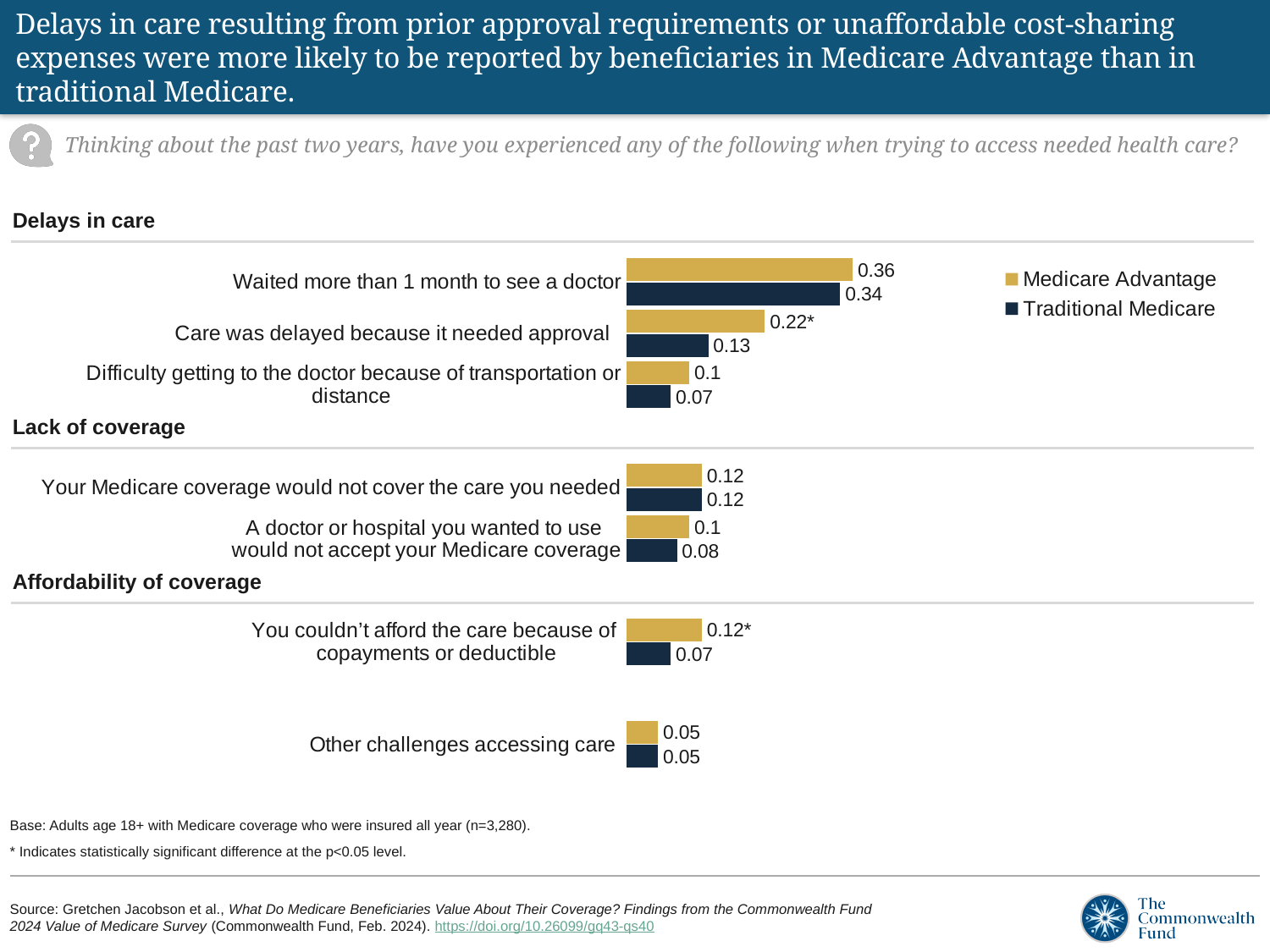
Which category has the highest Medicare Advantage value? Waited more than 1 month to see a doctor What is the Traditional Medicare value for "Care was delayed because it needed approval"? 0.13 For "A doctor or hospital you wanted to use would not accept your Medicare coverage", which series has the larger value, Medicare Advantage or Traditional Medicare? Medicare Advantage What kind of chart is shown on the slide? Bar chart What is the Medicare Advantage value for "You couldn't afford the care because of copayments or deductible"? 0.12* How many categories are plotted in the chart? 7 Which colour represents Traditional Medicare in the legend? Dark navy blue How many series does the legend list? 2 What is the Medicare Advantage value for "Waited more than 1 month to see a doctor"? 0.36 What is the difference between the Medicare Advantage and Traditional Medicare values for "Care was delayed because it needed approval"? 0.09 Which category has the lowest Traditional Medicare value? Other challenges accessing care What is the Traditional Medicare value for "Difficulty getting to the doctor because of transportation or distance"? 0.07